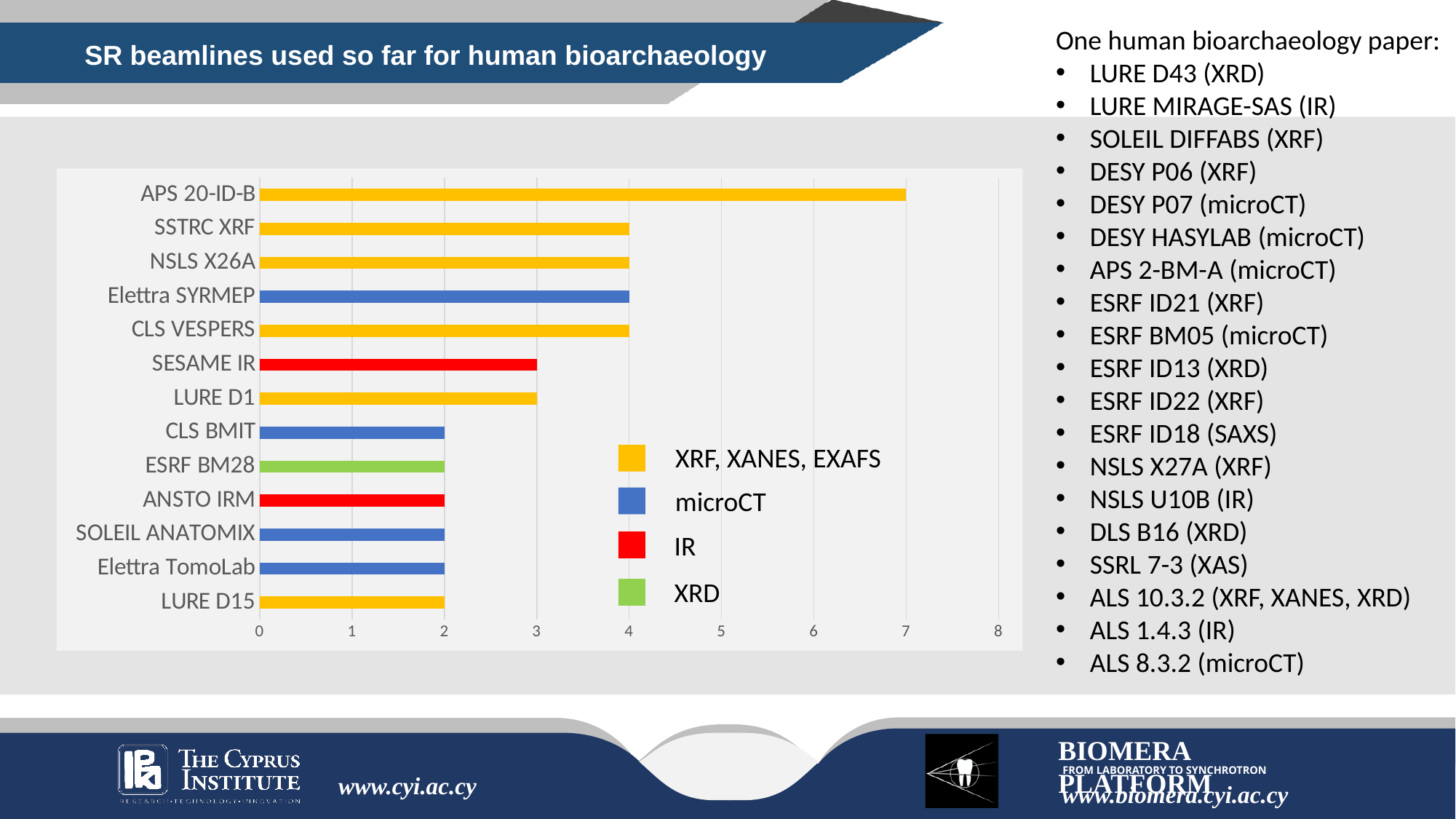
What is the value for APS 20-ID-B? 7 What is the value for Elettra SYRMEP? 4 How many entries does the chart legend list? 4 What is the difference between the values for APS 20-ID-B and CLS VESPERS? 3 What is the value for LURE D15? 2 Which legend entry is shown in green? XRD How many beamlines are listed in the chart? 13 Which beamline has the highest value in the chart? APS 20-ID-B What is the value for SESAME IR? 3 What type of chart is shown on the slide? bar chart Is the value for APS 20-ID-B greater or less than 5? greater Which is larger, the value for LURE D1 or the value for CLS BMIT? LURE D1